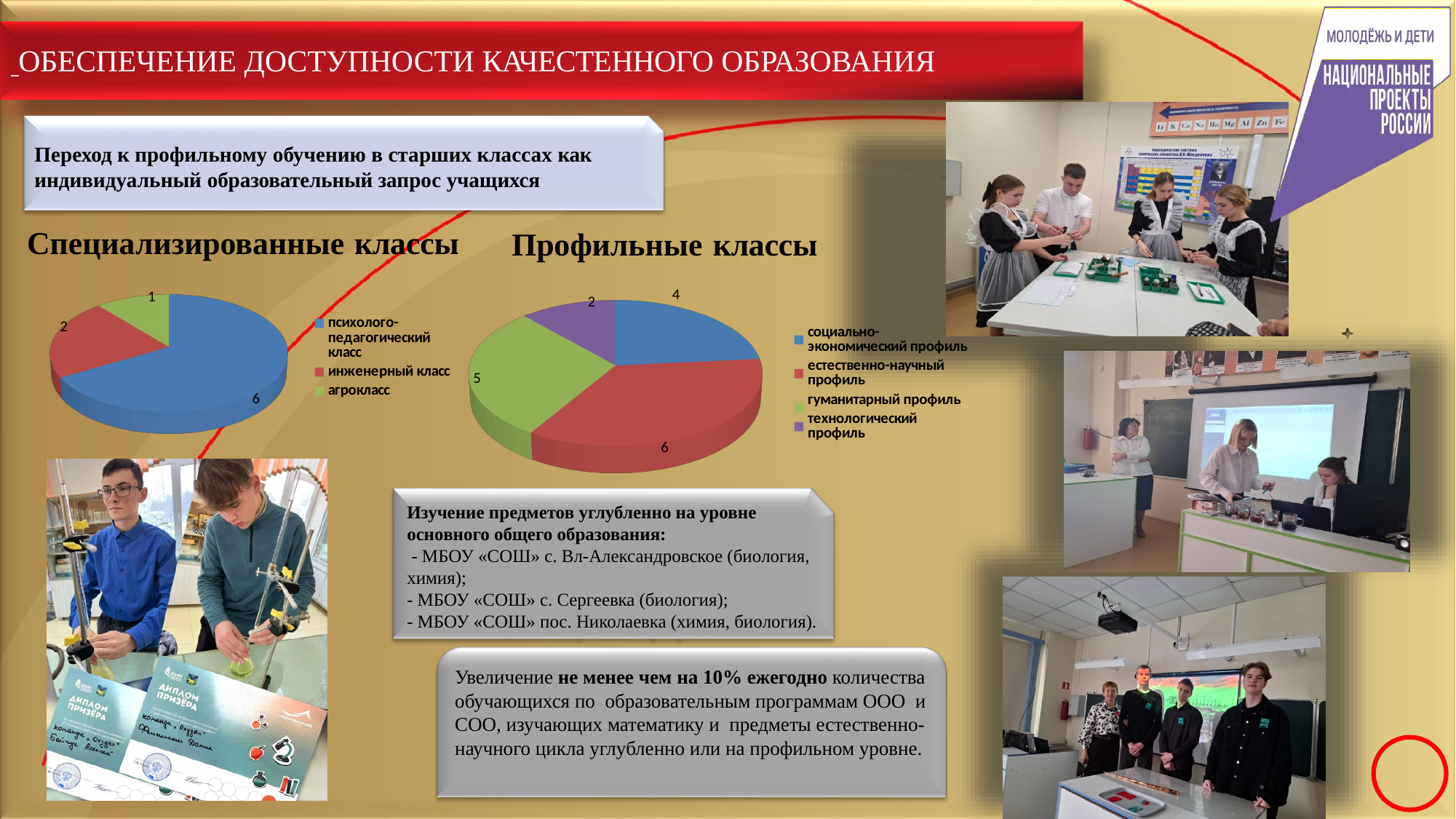
In the 'Профильные классы' chart, which profile has the largest value? естественно-научный профиль In the 'Профильные классы' chart, what is the value for естественно-научный профиль? 6 In the 'Профильные классы' chart, what colour represents технологический профиль? purple In the 'Профильные классы' chart, which is larger: социально-экономический профиль or технологический профиль? социально-экономический профиль In the 'Специализированные классы' chart, what is the value for инженерный класс? 2 In the 'Специализированные классы' chart, what is the value for психолого-педагогический класс? 6 In the 'Профильные классы' chart, what is the value for гуманитарный профиль? 5 In the 'Профильные классы' chart, how many categories are shown? 4 What type of chart is used for 'Специализированные классы'? pie chart In the 'Специализированные классы' chart, what is the difference between психолого-педагогический класс and инженерный класс? 4 In the 'Специализированные классы' chart, which category has the smallest value? агрокласс In the 'Специализированные классы' chart, how many categories does the legend list? 3